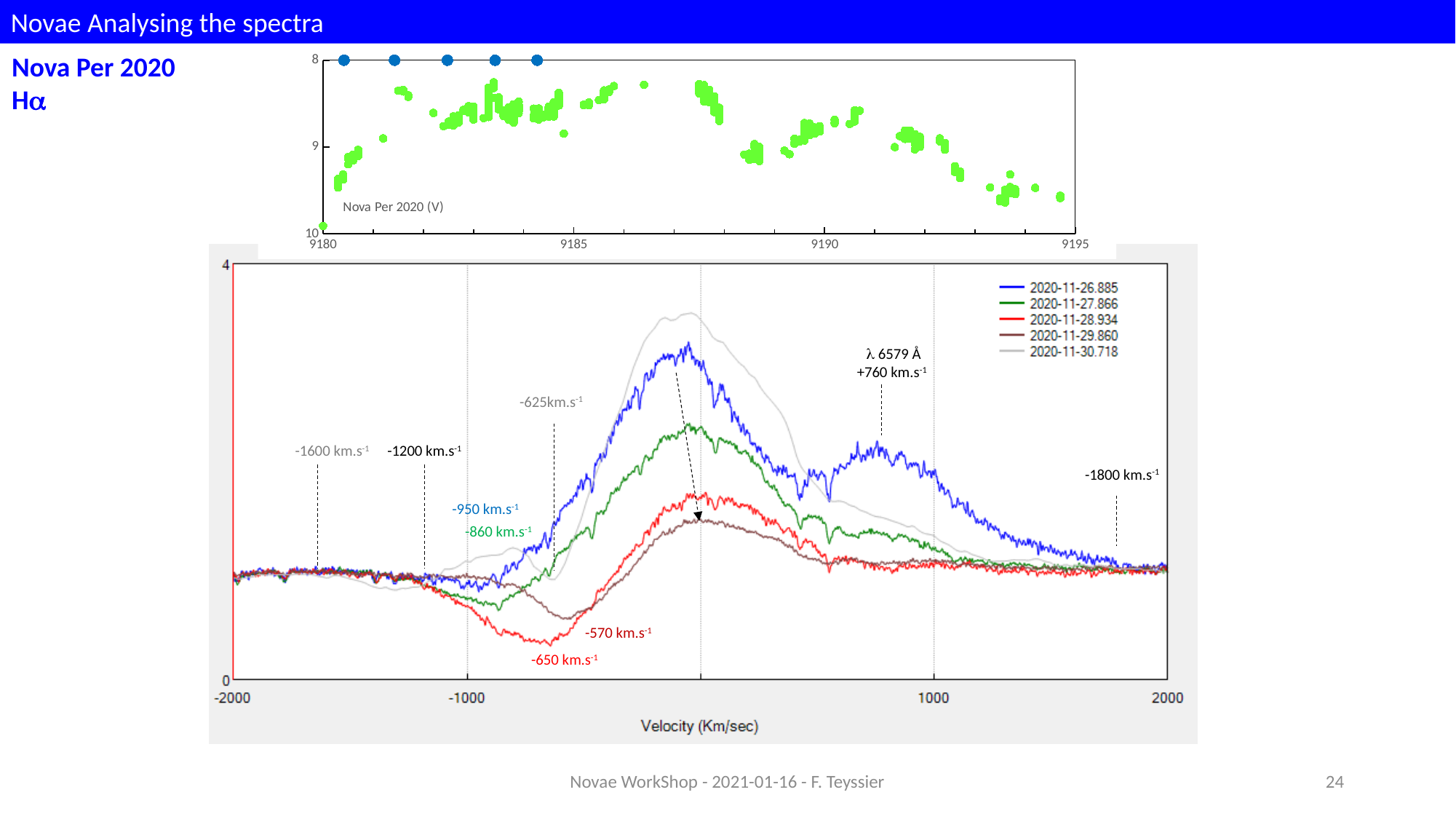
What kind of chart is the bottom chart? line chart What kind of chart is the top chart? scatter chart On the bottom spectrum chart, what velocity is annotated in red at the deepest absorption trough? -650 km.s-1 On the bottom spectrum chart, what velocity is annotated in blue? -950 km.s-1 On the bottom spectrum chart, which series reaches the highest peak? 2020-11-30.718 On the bottom spectrum chart, what velocity is annotated in green? -860 km.s-1 On the bottom spectrum chart, what wavelength is annotated next to the +760 km.s-1 feature? λ 6579 Å On the top chart, what is the highest value shown on the x axis? 9195 On the bottom spectrum chart, how many series does the legend list? 5 On the top light-curve chart, how many blue dots are plotted along the top edge? 5 On the bottom spectrum chart, which legend entry corresponds to the blue line? 2020-11-26.885 On the bottom spectrum chart, what is the label of the x axis? Velocity (Km/sec)